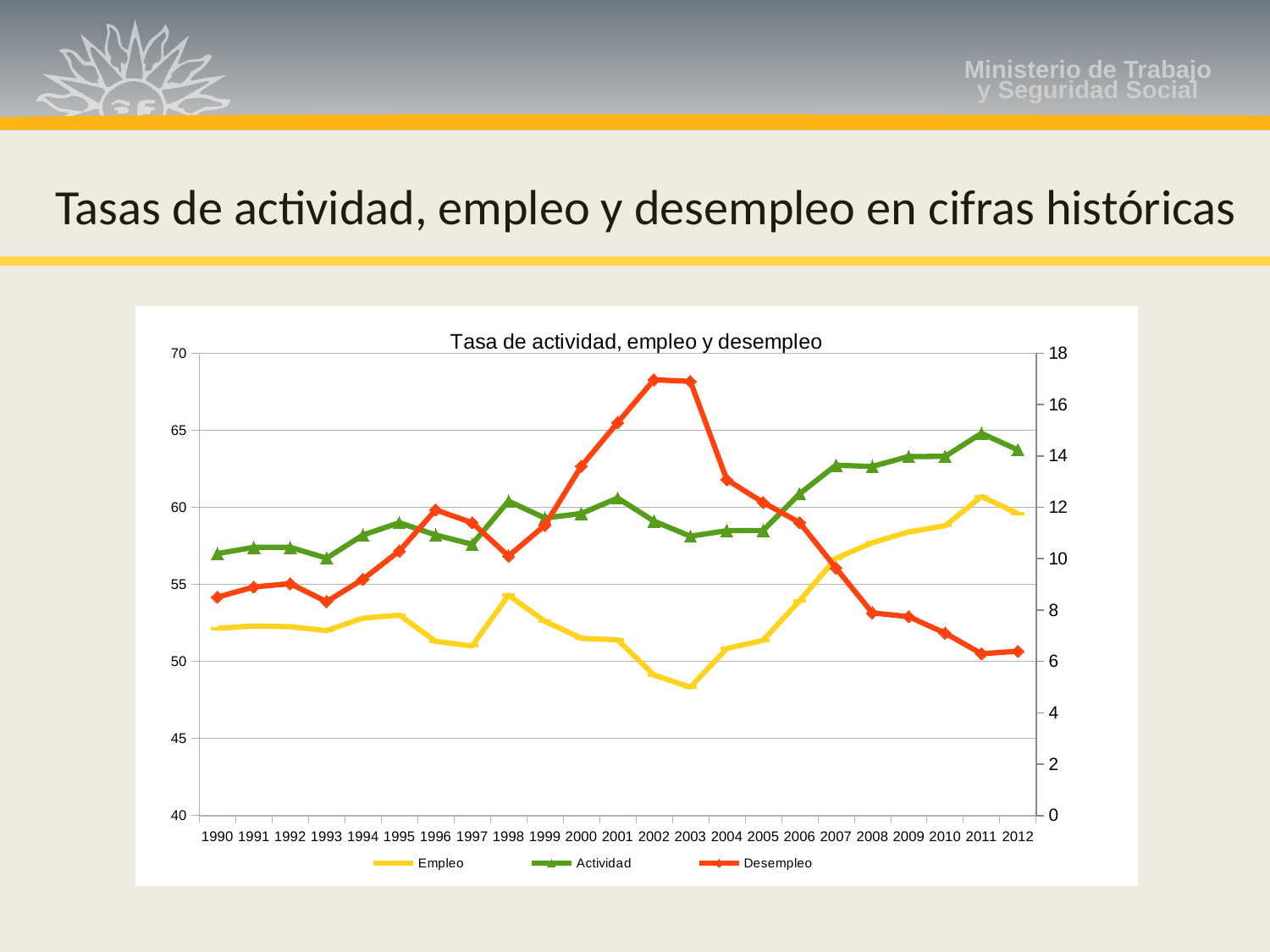
How many series does the legend list? 3 Is the Empleo value for 2003 greater or less than 50 on the left axis? less In which year is the Empleo series at its highest? 2011 Which series is higher in 2000, Actividad or Empleo? Actividad In which year is the Empleo series at its lowest? 2003 Is the Actividad value for 2011 greater or less than 60 on the left axis? greater What is the title of the chart? Tasa de actividad, empleo y desempleo Does the Desempleo series rise or fall from 2002 to 2011? fall Is the Desempleo value for 2002 greater or less than 16 on the right axis? greater What kind of chart is shown on the slide? line chart In which year is the Actividad series at its highest? 2011 How many years are plotted along the x axis? 23